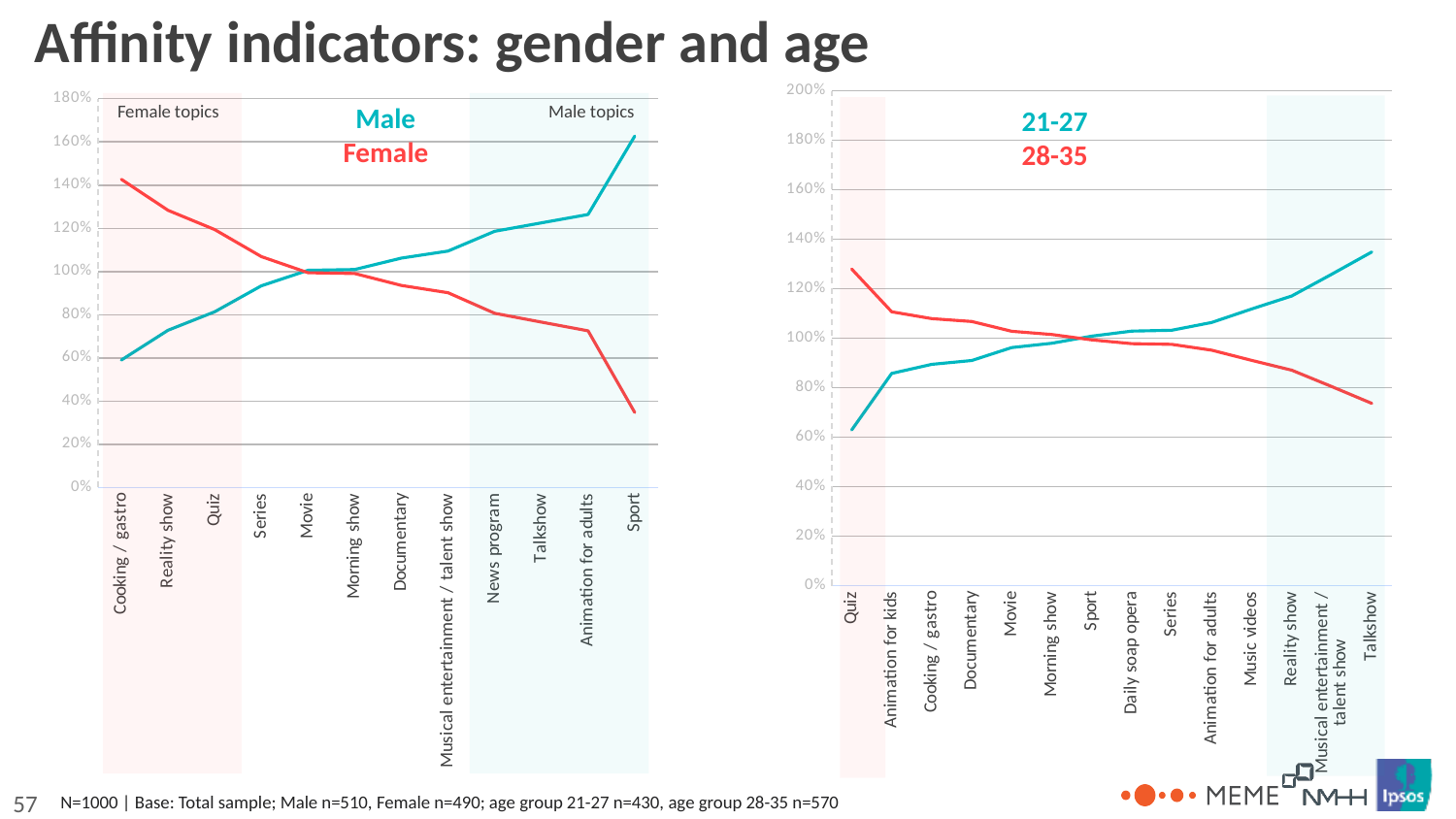
In the left chart, is the Female value for Sport greater or less than 40%? less In the left chart, which category has the highest value for the Male series? Sport How many categories are shown on the x axis of the right chart (21-27 / 28-35)? 14 How many categories are shown on the x axis of the left chart (Male / Female)? 12 In the right chart, is the 21-27 value for Talkshow greater or less than 120%? greater How many series does the legend of the right chart list? 2 In the left chart, which series has the larger value for Cooking / gastro, Male or Female? Female In the left chart, does the Female line rise or fall from left to right along the x axis? fall What kind of chart is the left chart (Male / Female)? line chart In the left chart, is the Male value for Sport greater or less than 140%? greater In the left chart, which category has the lowest value for the Female series? Sport In the right chart, which series has the larger value for Quiz, 21-27 or 28-35? 28-35